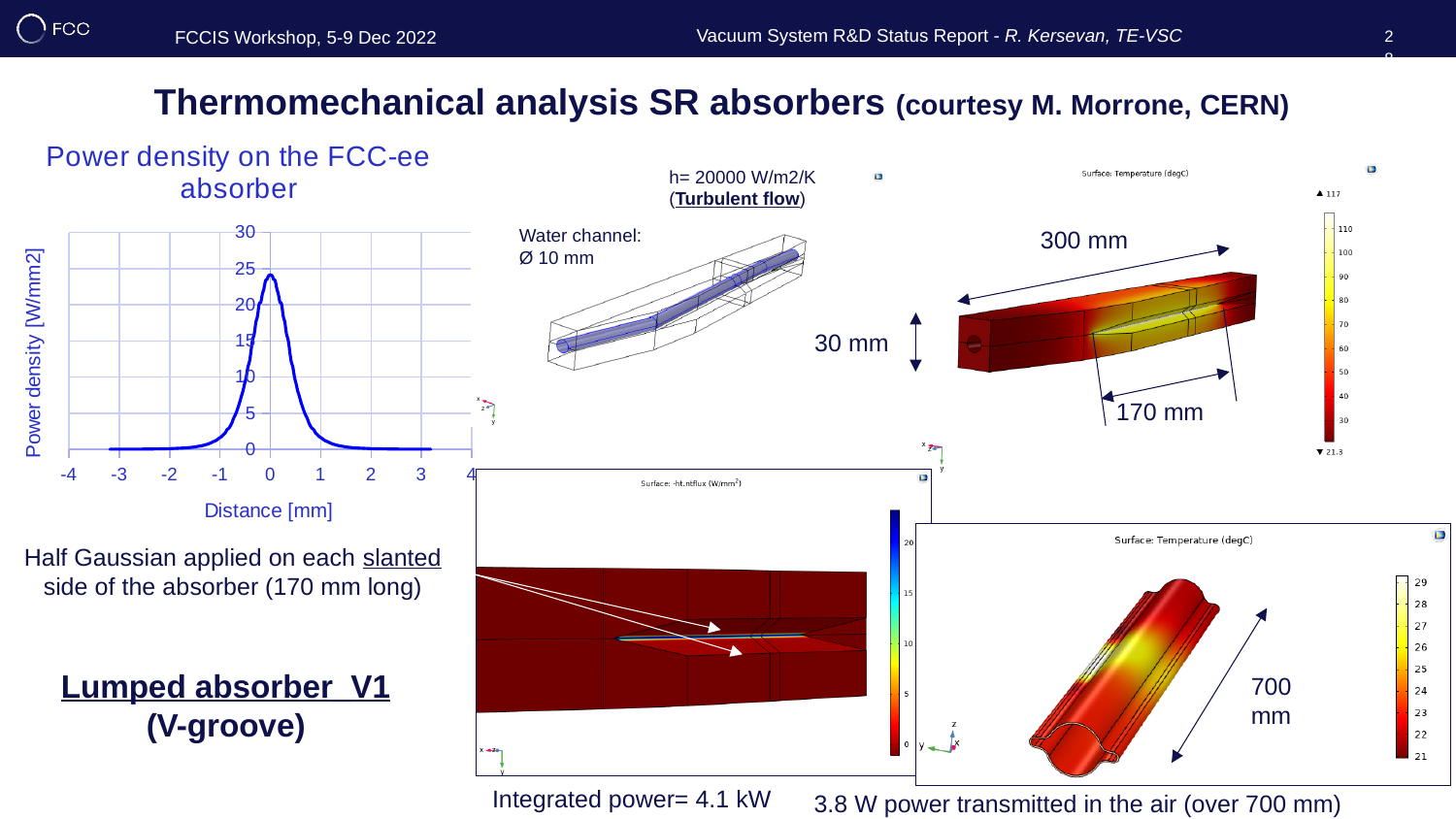
In the 'Power density on the FCC-ee absorber' chart, does the power density rise or fall as the distance goes from 0 mm to 4 mm? fall In the 'Power density on the FCC-ee absorber' chart, is the peak power density greater or less than 30 W/mm2? less In the 'Power density on the FCC-ee absorber' chart, is the power density at a distance of -3 mm greater or less than 5 W/mm2? less What kind of chart is the 'Power density on the FCC-ee absorber' chart? line chart What is the title of the chart on the left of the slide? Power density on the FCC-ee absorber In the 'Power density on the FCC-ee absorber' chart, is the peak power density greater or less than 20 W/mm2? greater In the 'Power density on the FCC-ee absorber' chart, which is larger: the power density at 0 mm or at 2 mm? 0 mm In the 'Power density on the FCC-ee absorber' chart, at what distance does the power density reach its maximum? 0 mm In the 'Power density on the FCC-ee absorber' chart, what is the highest value shown on the y axis? 30 What is the label of the x axis of the 'Power density on the FCC-ee absorber' chart? Distance [mm] In the 'Power density on the FCC-ee absorber' chart, does the power density rise or fall as the distance goes from -4 mm to 0 mm? rise